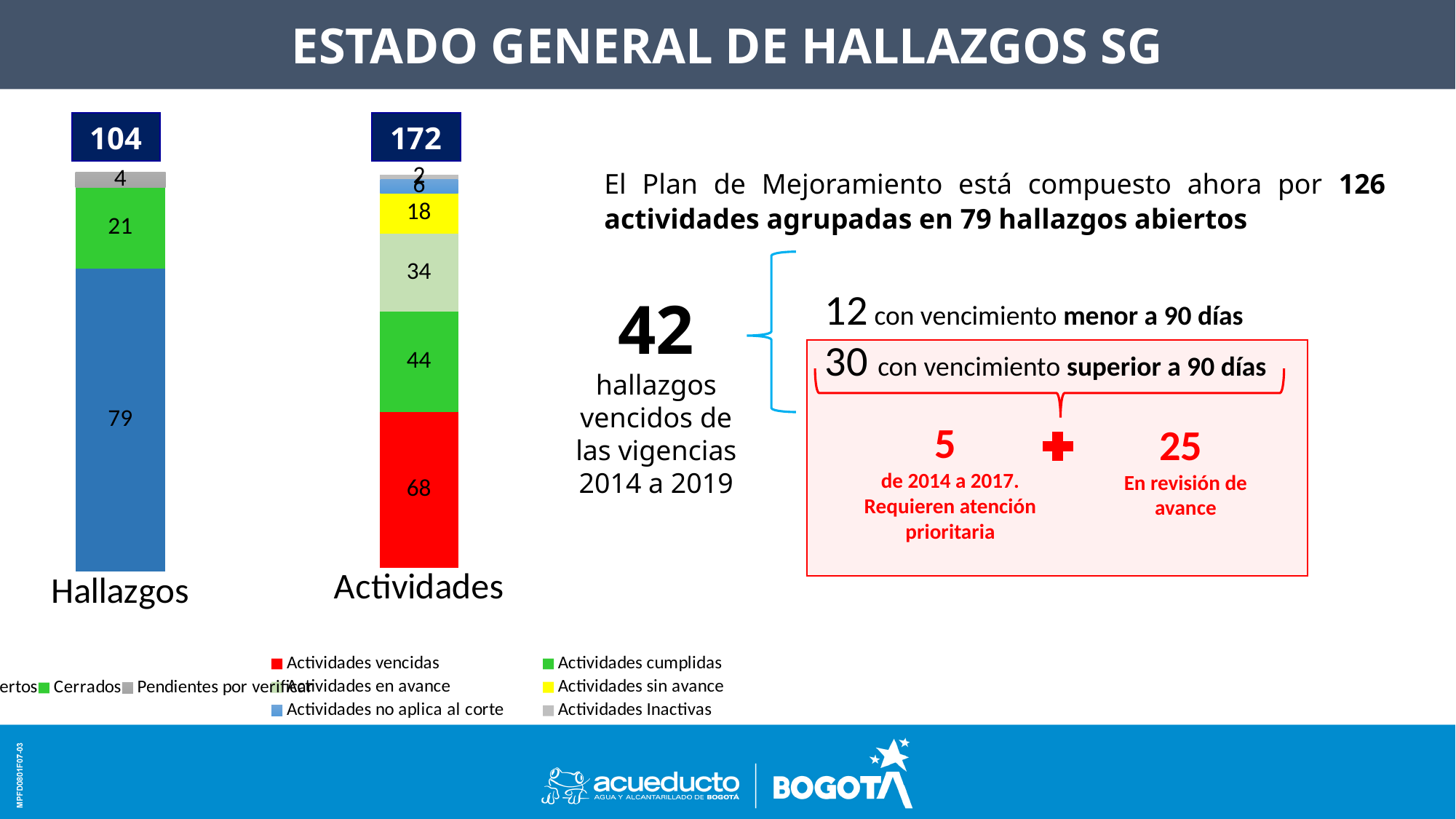
In the Actividades chart, what is the value for Actividades cumplidas? 44 In the Actividades chart, which segment is the smallest? Actividades Inactivas In the Actividades chart, what is the value for Actividades vencidas? 68 In the Actividades chart, what is the total shown above the stacked bar? 172 In the Actividades chart, what is the value for Actividades sin avance? 18 In the Actividades chart, what is the difference between Actividades vencidas and Actividades cumplidas? 24 In the Hallazgos chart, what is the value for Cerrados? 21 In the Actividades chart, which is larger: Actividades en avance or Actividades sin avance? Actividades en avance In the Hallazgos chart, what is the value of the largest segment? 79 In the Actividades chart, which segment is the largest? Actividades vencidas In the Hallazgos chart, what is the total shown above the stacked bar? 104 How many series does the legend of the Actividades chart list? 6